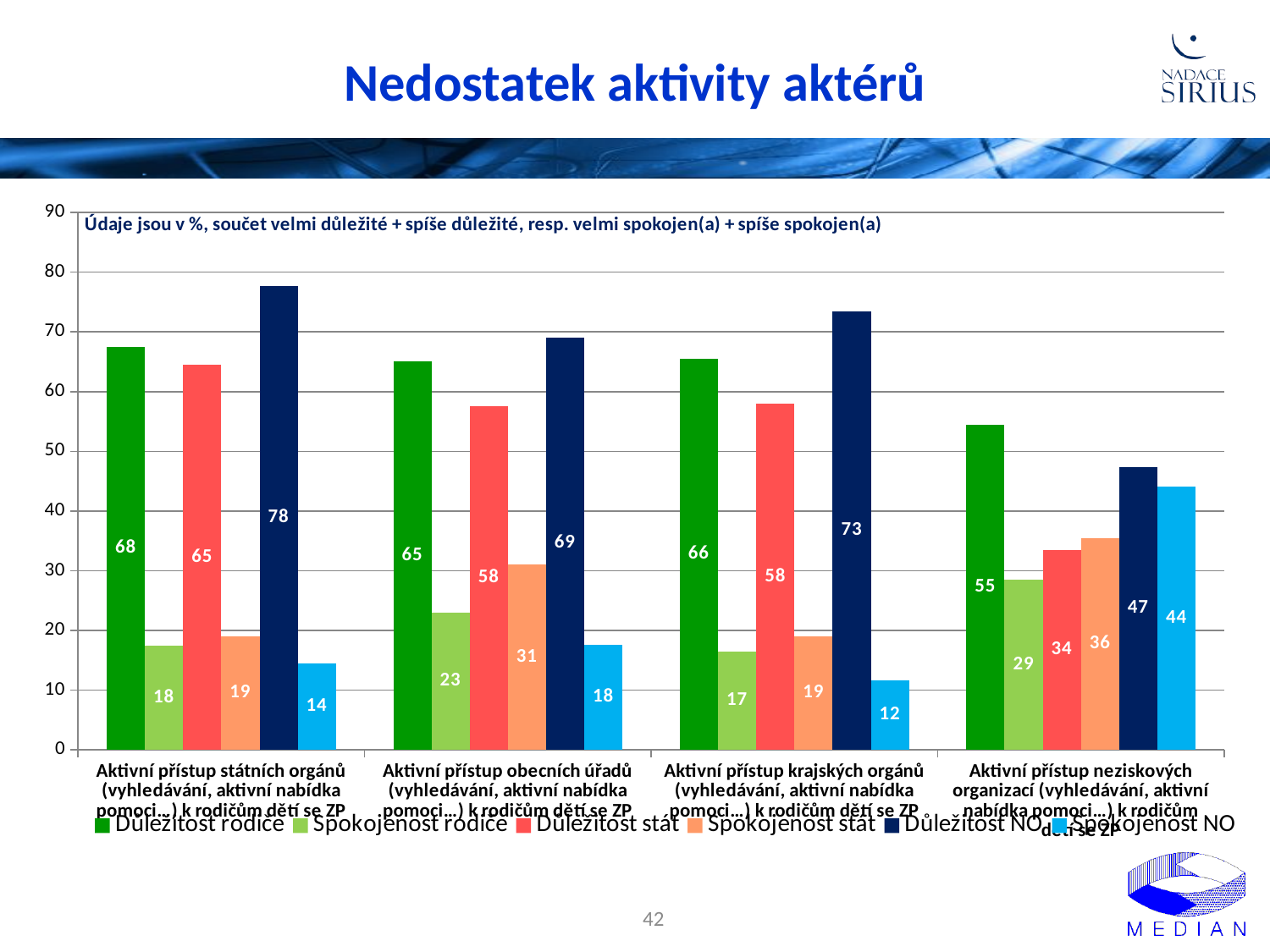
What is the difference between Důležitost rodiče and Spokojenost rodiče for Aktivní přístup státních orgánů? 50 Which category has the lowest value for Spokojenost NO? Aktivní přístup krajských orgánů What type of chart is shown on the slide? bar chart What is the value of Důležitost NO for Aktivní přístup státních orgánů? 78 How many series does the legend list? 6 What is the value of Spokojenost NO for Aktivní přístup neziskových organizací? 44 Is the value of Důležitost NO for Aktivní přístup krajských orgánů greater or less than 70? greater How many categories are shown on the x axis? 4 Which category has the highest value for Důležitost NO? Aktivní přístup státních orgánů Which is larger for Aktivní přístup neziskových organizací: Důležitost stát or Spokojenost stát? Spokojenost stát What is the title of the slide? Nedostatek aktivity aktérů What is the value of Spokojenost stát for Aktivní přístup obecních úřadů? 31